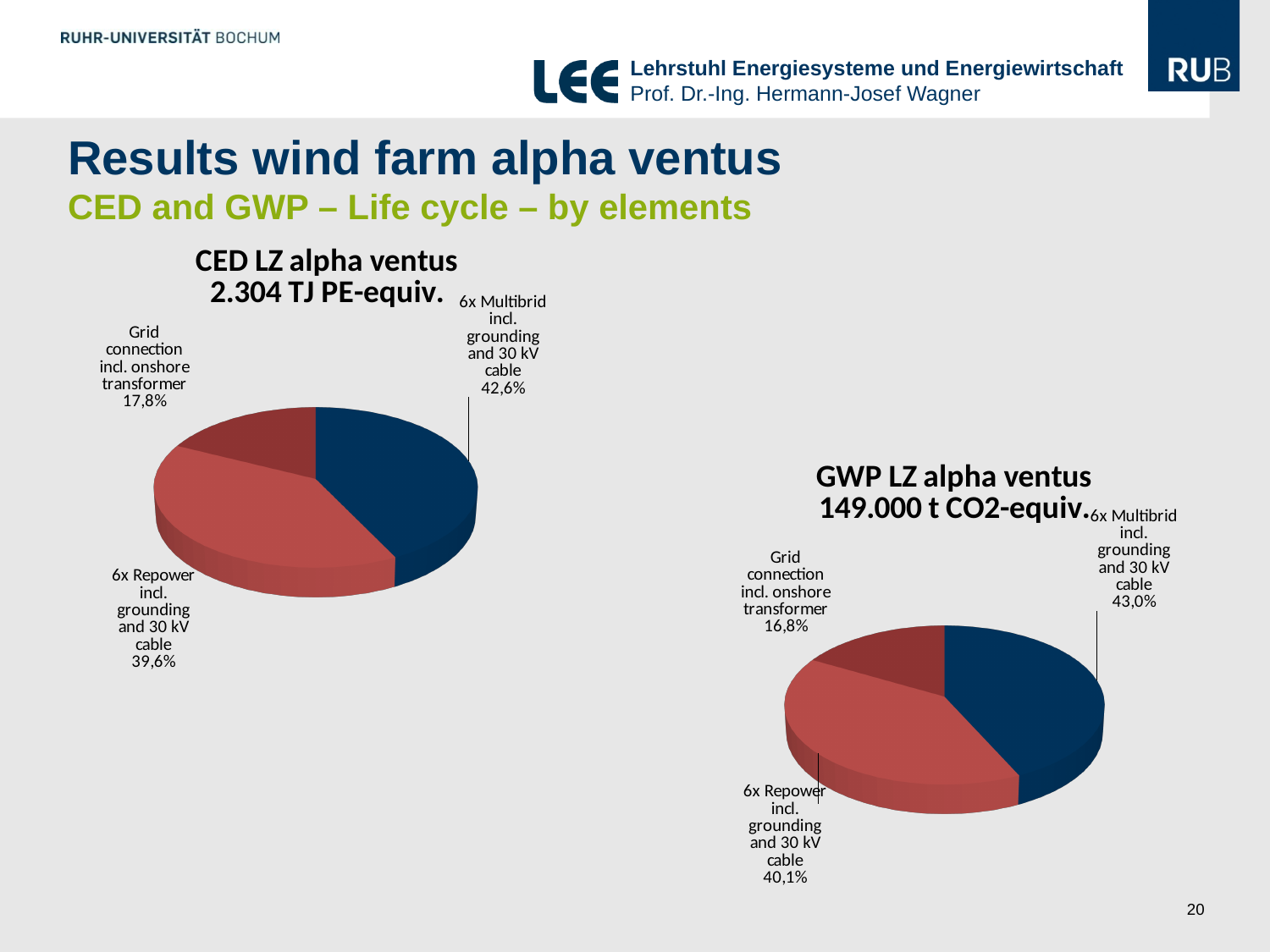
In the CED LZ alpha ventus chart, which element has the smallest share? Grid connection incl. onshore transformer In the GWP LZ alpha ventus chart, which element has the smallest share? Grid connection incl. onshore transformer In the CED LZ alpha ventus chart, which element has the largest share? 6x Multibrid incl. grounding and 30 kV cable What kind of chart is the CED LZ alpha ventus chart? Pie chart How many slices does the GWP LZ alpha ventus pie chart have? 3 What total value is stated in the title of the GWP LZ alpha ventus chart? 149.000 t CO2-equiv. In the GWP LZ alpha ventus chart, what share does Grid connection incl. onshore transformer have? 16,8% In the CED LZ alpha ventus chart, what share does Grid connection incl. onshore transformer have? 17,8% In the CED LZ alpha ventus chart, what share does 6x Multibrid incl. grounding and 30 kV cable have? 42,6%